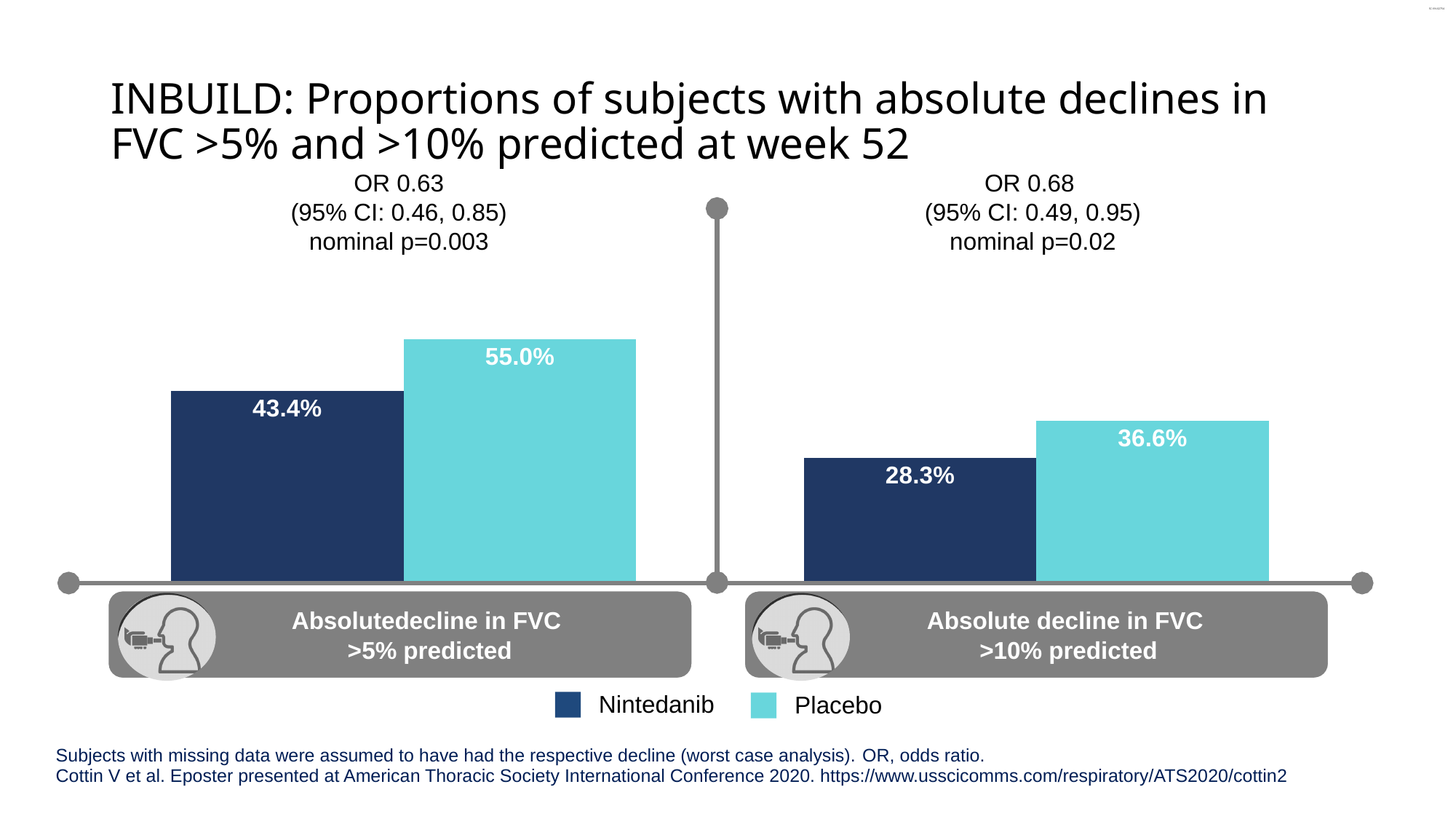
What is the difference between the Placebo and Nintedanib values for absolute decline in FVC >10% predicted? 8.3% What kind of chart is shown on the slide? Bar chart How many series does the legend list? 2 What proportion of Nintedanib subjects had an absolute decline in FVC >10% predicted? 28.3% What proportion of Placebo subjects had an absolute decline in FVC >10% predicted? 36.6% Which bar shows the lowest value on the chart? Nintedanib, absolute decline in FVC >10% predicted What is the difference between the Placebo and Nintedanib values for absolute decline in FVC >5% predicted? 11.6% For absolute decline in FVC >10% predicted, which group has the larger proportion, Nintedanib or Placebo? Placebo What odds ratio is shown above the absolute decline in FVC >5% predicted group? OR 0.63 Which bar shows the highest value on the chart? Placebo, absolute decline in FVC >5% predicted What proportion of Placebo subjects had an absolute decline in FVC >5% predicted? 55.0% What proportion of Nintedanib subjects had an absolute decline in FVC >5% predicted? 43.4%